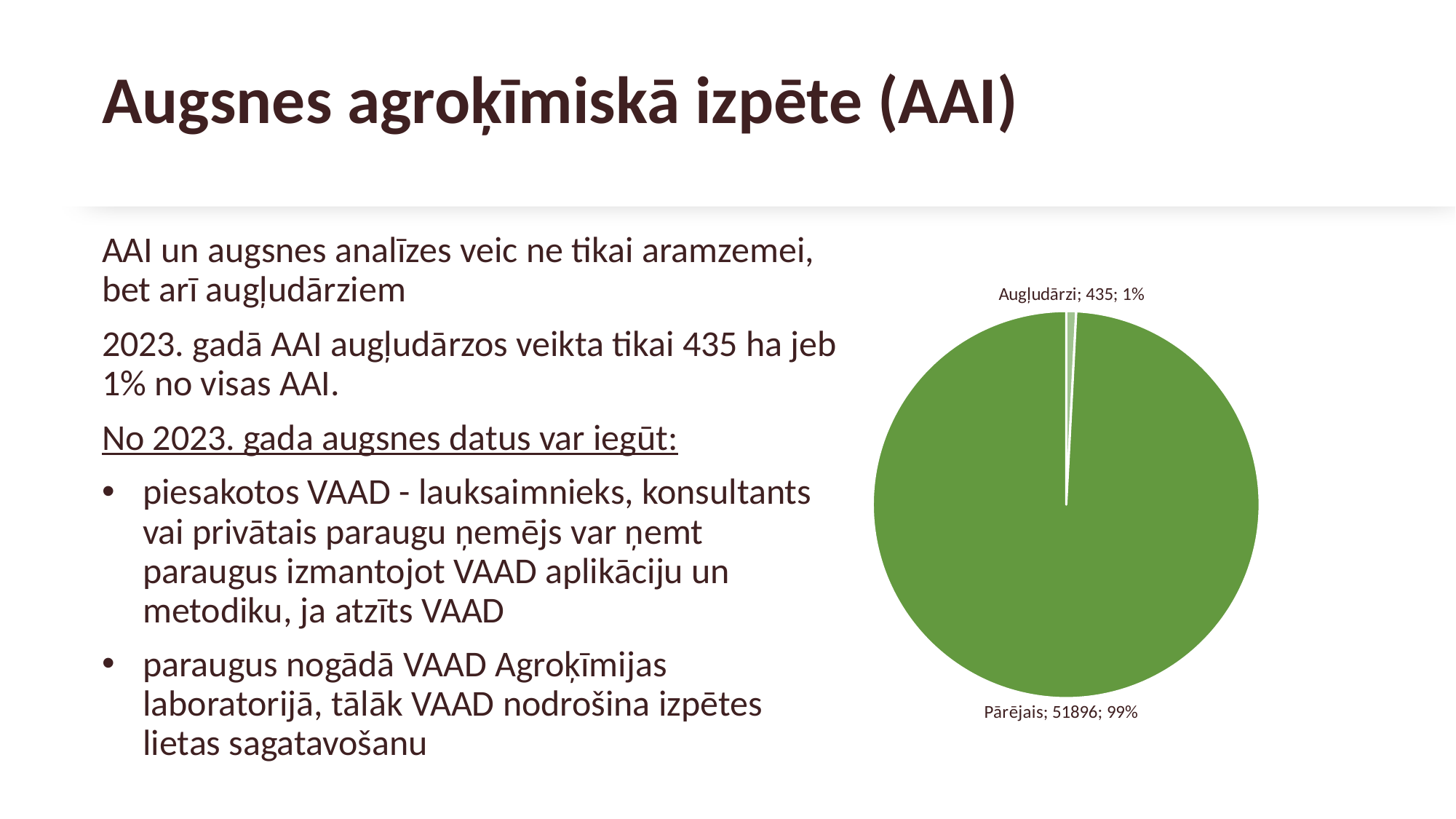
What is the value for Pārējais in the pie chart? 51896 Which slice of the pie chart is the largest? Pārējais Which slice of the pie chart is the smallest? Augļudārzi How many slices does the pie chart have? 2 What is the value for Augļudārzi in the pie chart? 435 What share of the pie does Pārējais represent? 99% Which is larger, the value for Augļudārzi or the value for Pārējais? Pārējais What is the total of the two values shown in the pie chart? 52331 What is the difference between the values for Pārējais and Augļudārzi? 51461 What colour is the Pārējais slice of the pie chart? green What kind of chart is shown on the slide? pie chart What share of the pie does Augļudārzi represent? 1%